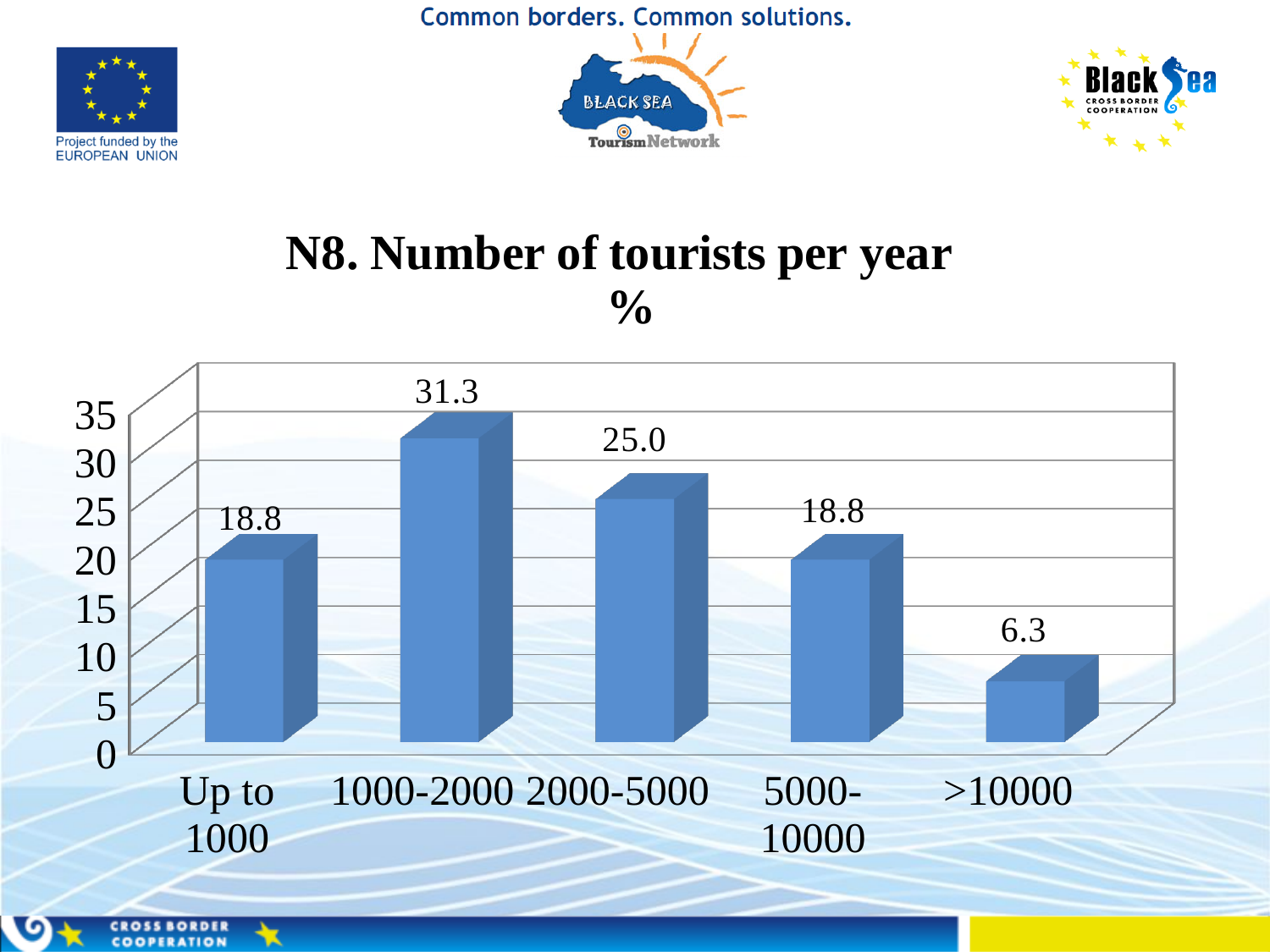
What is the difference between the values for 1000-2000 and 2000-5000? 6.3 What is the title of the chart? N8. Number of tourists per year % Which category has the lowest value? >10000 Is the value for 1000-2000 greater or less than 30? greater Which category has the highest value? 1000-2000 What is the value for the 2000-5000 category? 25.0 What is the difference between the values for Up to 1000 and >10000? 12.5 What kind of chart is shown on the slide? bar chart What is the value for the 1000-2000 category? 31.3 Which is larger, the value for 2000-5000 or the value for 5000-10000? 2000-5000 How many categories are shown on the x axis? 5 What is the value for the >10000 category? 6.3